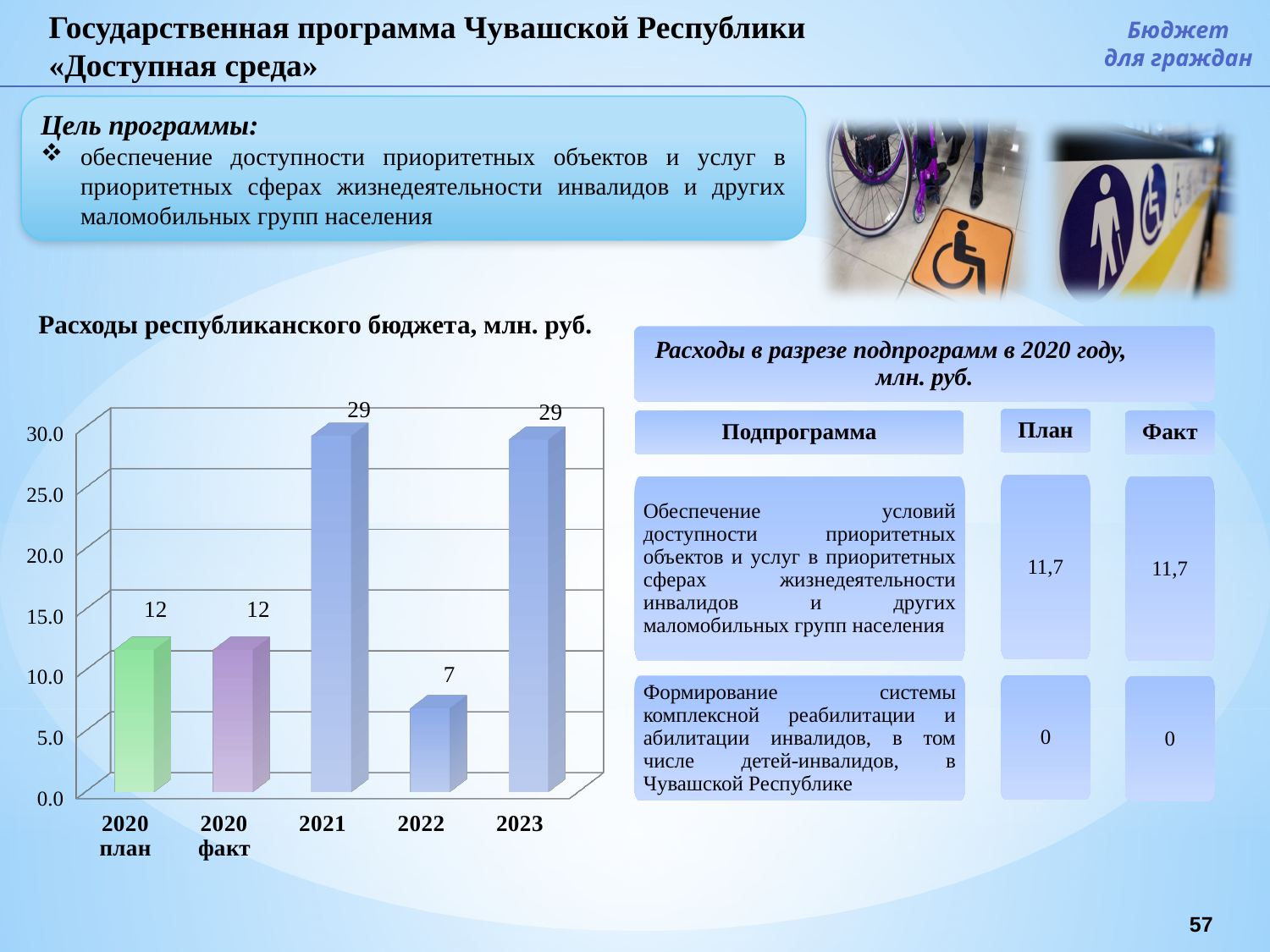
What is the value for 2021 in the chart 'Расходы республиканского бюджета, млн. руб.'? 29 What is the unit of measurement stated in the title of the chart 'Расходы республиканского бюджета'? млн. руб. What is the value for '2020 факт' in the chart 'Расходы республиканского бюджета, млн. руб.'? 12 What is the value for 2022 in the chart 'Расходы республиканского бюджета, млн. руб.'? 7 Which is larger in the chart 'Расходы республиканского бюджета, млн. руб.': the value for 2022 or the value for '2020 план'? 2020 план What is the difference between the values for 2023 and '2020 факт' in the chart 'Расходы республиканского бюджета, млн. руб.'? 17 Which category has the lowest value in the chart 'Расходы республиканского бюджета, млн. руб.'? 2022 Is the value for 2023 in the chart 'Расходы республиканского бюджета, млн. руб.' greater or less than 25.0? greater What kind of chart is 'Расходы республиканского бюджета, млн. руб.'? bar chart What is the value for '2020 план' in the chart 'Расходы республиканского бюджета, млн. руб.'? 12 What is the difference between the values for 2021 and 2022 in the chart 'Расходы республиканского бюджета, млн. руб.'? 22 How many bars are shown in the chart 'Расходы республиканского бюджета, млн. руб.'? 5